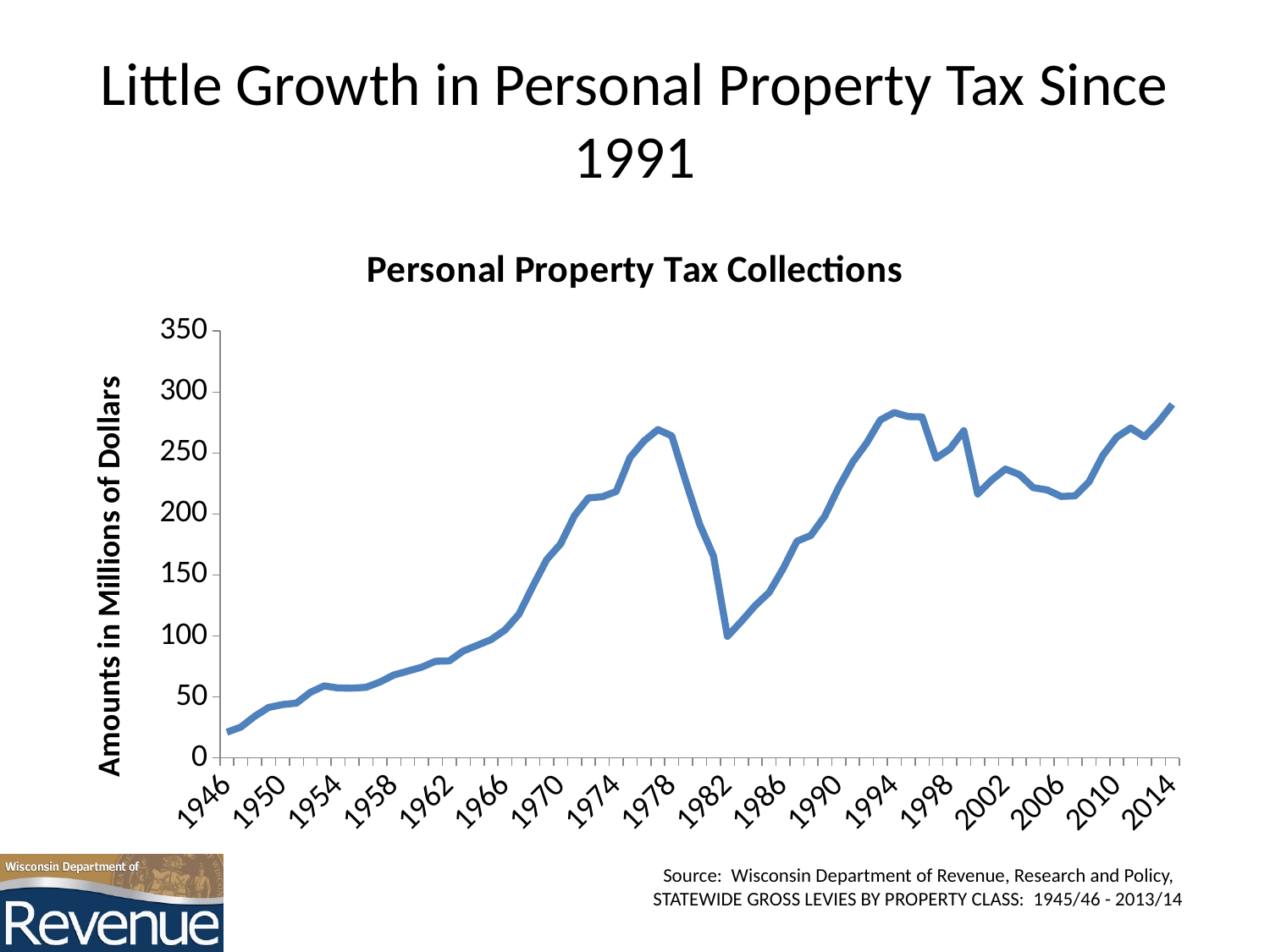
Which year has the lowest personal property tax collections on the chart? 1946 Is the value for 2014 greater or less than 250? greater What is the title of the chart? Personal Property Tax Collections Do the values rise or fall between 1978 and 1982? fall Is the value for 1962 greater or less than 100? less What kind of chart is shown on the slide? line chart Do the values rise or fall between 1946 and 1978? rise What is the label on the vertical axis of the chart? Amounts in Millions of Dollars Is the value for 2006 greater or less than 250? less